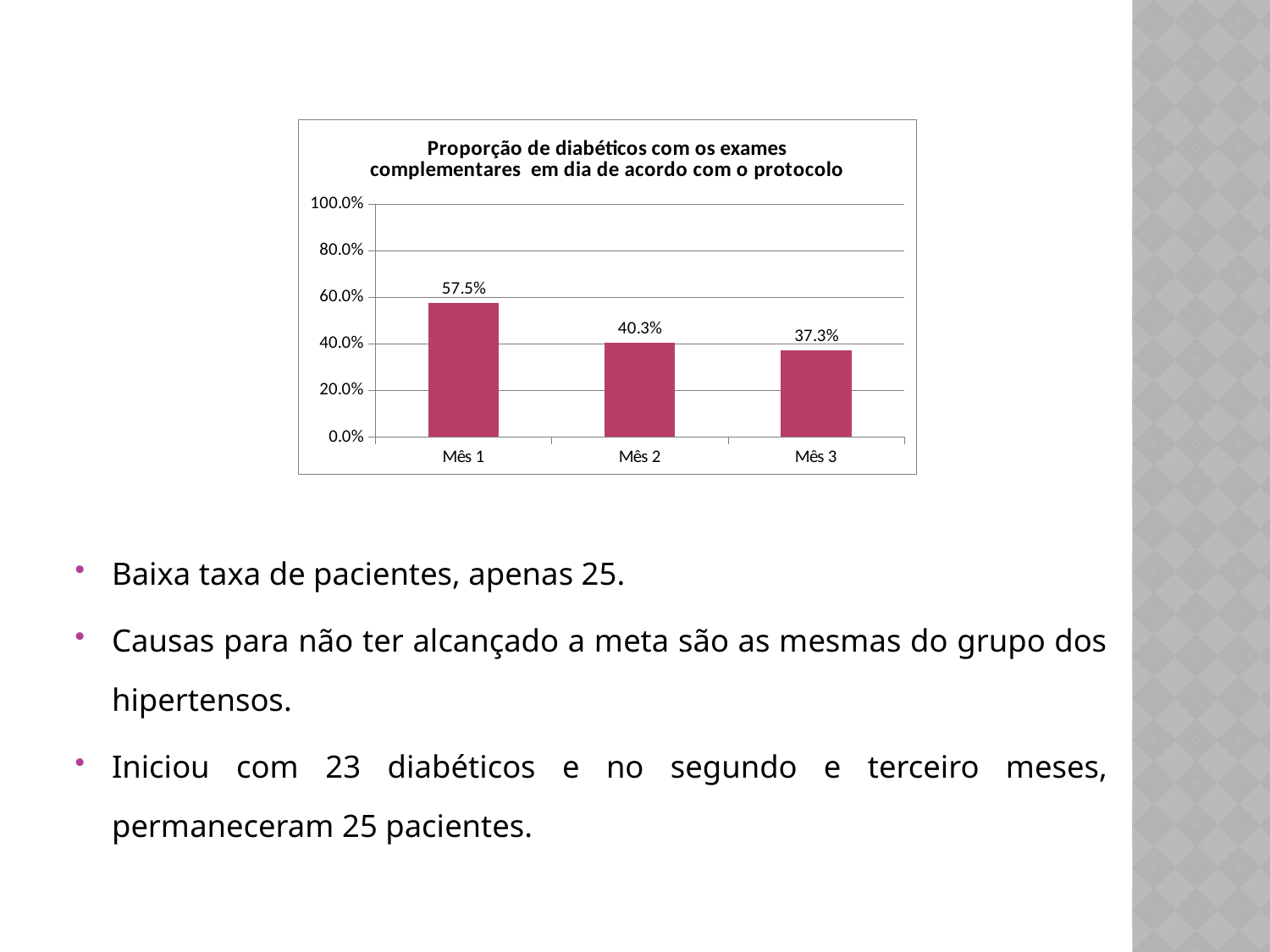
Which month has the lowest proportion? Mês 3 What is the value for Mês 3? 37.3% Which month has the highest proportion? Mês 1 Do the values rise or fall from Mês 1 to Mês 3? fall What is the value for Mês 1? 57.5% What is the difference between the values for Mês 2 and Mês 3? 3.0% What is the value for Mês 2? 40.3% How many months are shown on the x axis? 3 What kind of chart is shown? bar chart Which is larger, the value for Mês 1 or the value for Mês 3? Mês 1 What is the difference between the values for Mês 1 and Mês 2? 17.2% Is the value for Mês 1 greater or less than 40.0%? greater